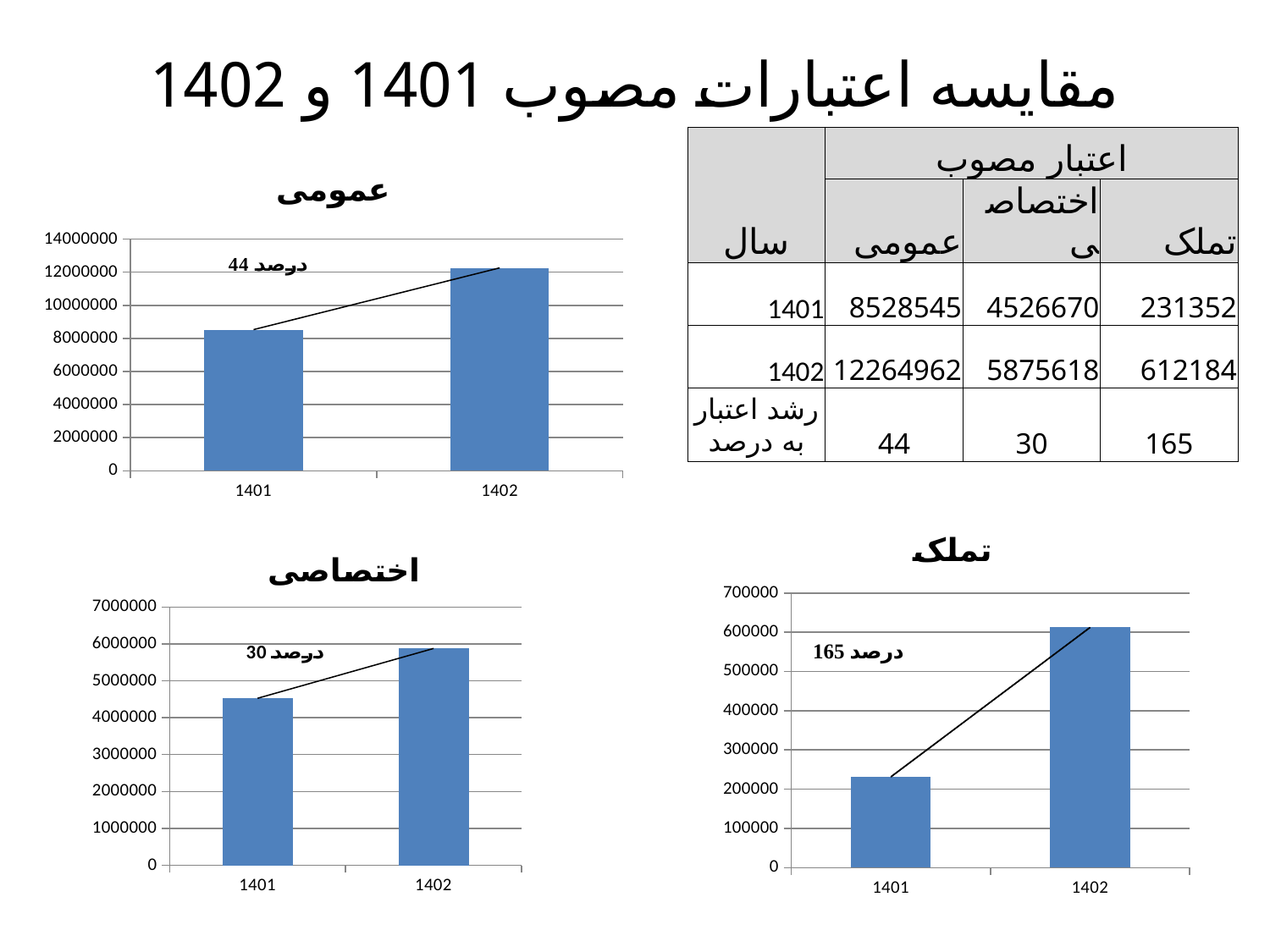
In the chart titled تملک, is the value for 1401 greater or less than 300000? less In the chart titled اختصاصی, is the value for 1401 greater or less than 5000000? less What kind of chart is the chart titled عمومی? bar chart In the chart titled عمومی, what growth percentage is written above the bars? 44 درصد In the chart titled عمومی, which year has the larger value, 1401 or 1402? 1402 In the chart titled اختصاصی, is the value for 1402 greater or less than 5000000? greater In the chart titled اختصاصی, what growth percentage is written above the bars? 30 درصد In the chart titled عمومی, how many categories are shown on the x axis? 2 In the chart titled تملک, which year has the highest value? 1402 In the chart titled عمومی, do the values rise or fall from 1401 to 1402? rise